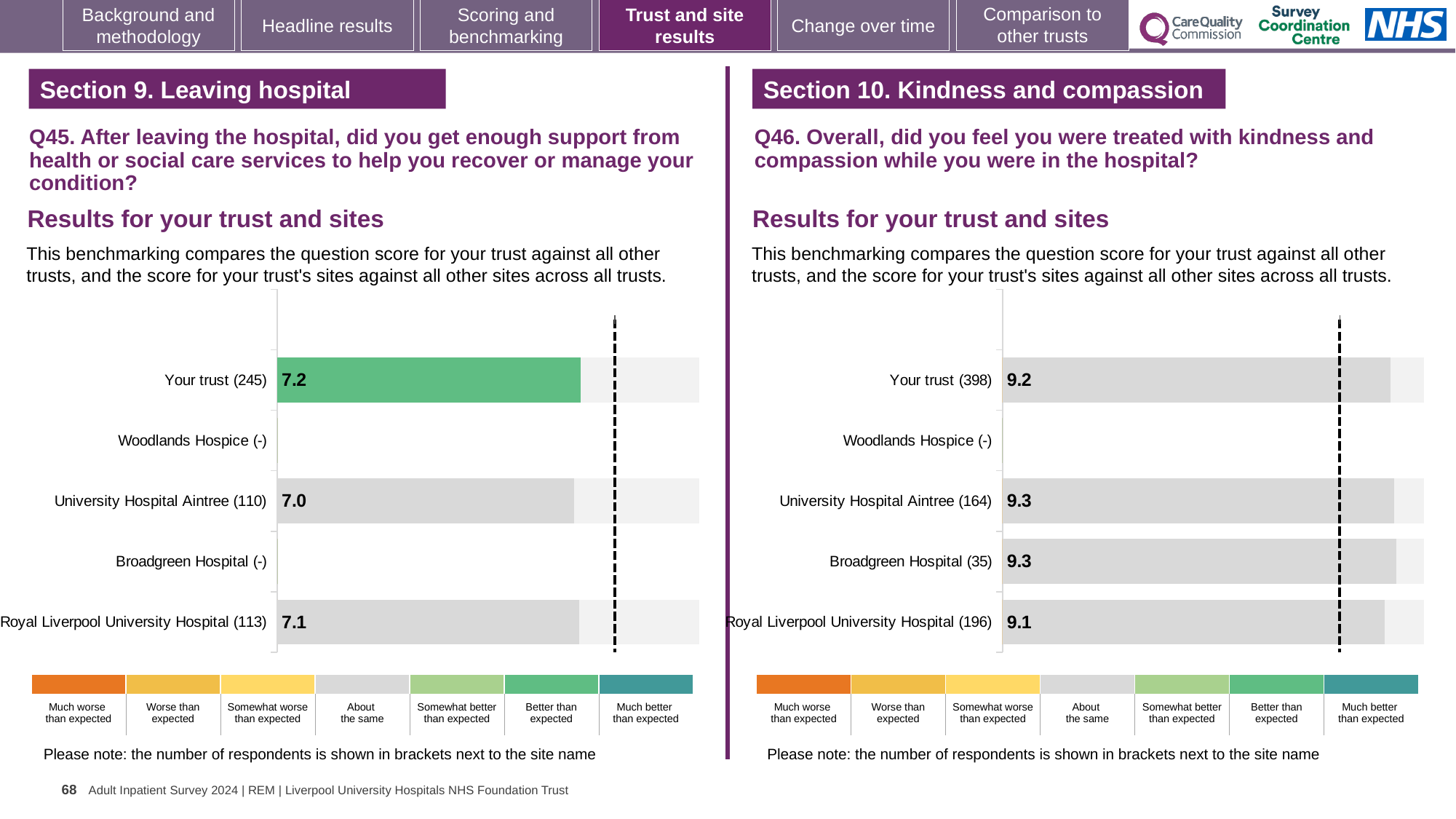
In the Q45 chart on the left, what is the score for Royal Liverpool University Hospital? 7.1 What kind of chart is the Q46 chart on the right? bar chart In the Q46 chart on the right, what is the score for Broadgreen Hospital? 9.3 In the Q46 chart on the right, which row has the lowest score? Royal Liverpool University Hospital In the Q45 chart on the left, which site or trust row has the highest score? Your trust In the Q45 chart on the left, what is the difference between the score for Your trust and the score for University Hospital Aintree? 0.2 In the Q45 chart on the left, what is the score for Your trust? 7.2 In the Q45 chart on the left, what is the score for University Hospital Aintree? 7.0 How many rows (trust and sites) are listed on the vertical axis of the Q45 chart on the left? 5 In the Q46 chart on the right, what is the score for Your trust? 9.2 In the Q46 chart on the right, what is the difference between the score for Broadgreen Hospital and the score for Royal Liverpool University Hospital? 0.2 In the Q46 chart on the right, is the score for University Hospital Aintree larger or smaller than the score for Royal Liverpool University Hospital? larger